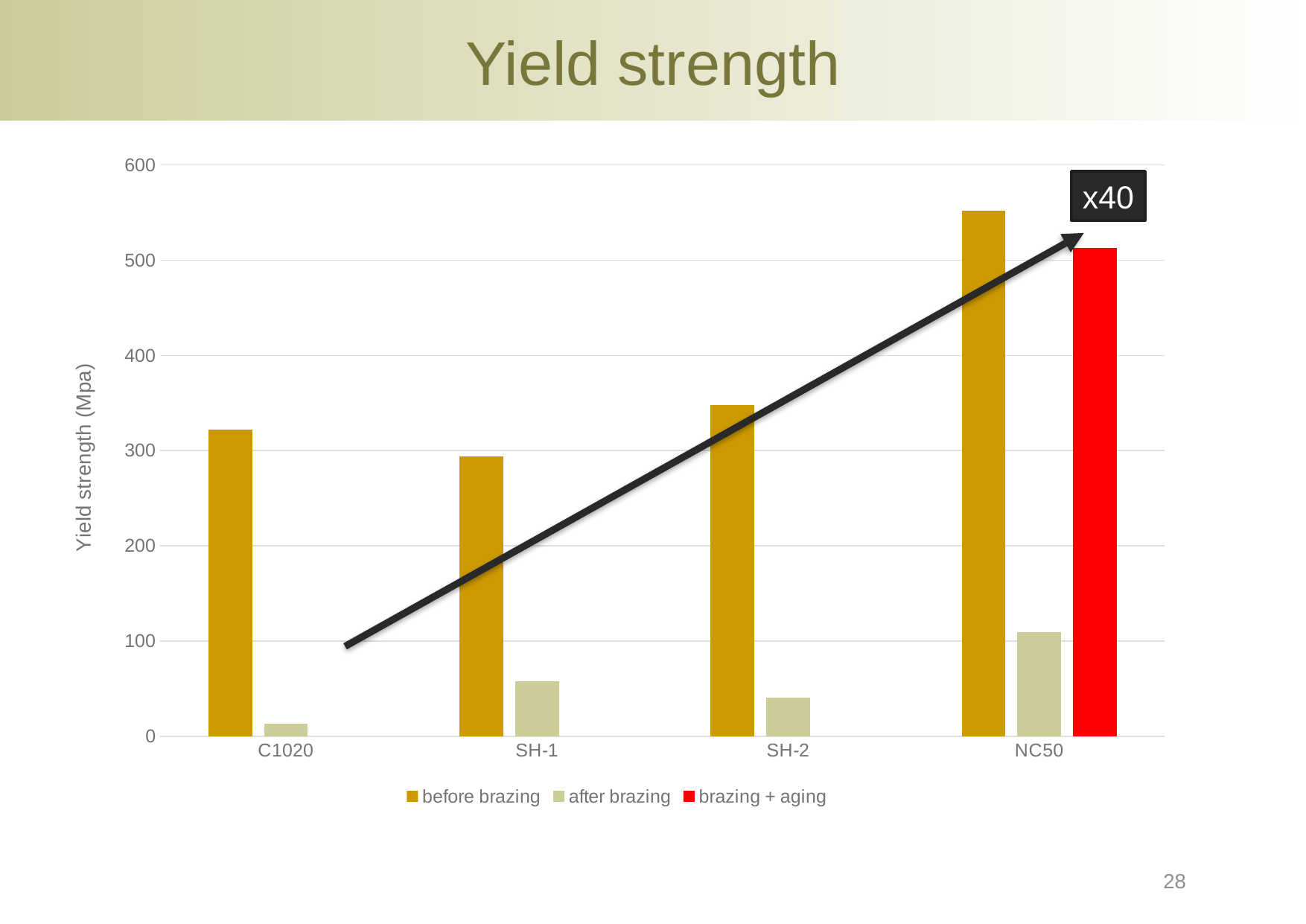
Is the 'before brazing' value for NC50 greater or less than 500? greater What kind of chart is shown on the slide? bar chart Is the 'after brazing' value for SH-1 greater or less than 100? less Which category has the highest 'before brazing' value? NC50 Which category is the only one with a 'brazing + aging' bar? NC50 How many categories are shown on the x axis? 4 Which is larger for SH-2: the 'before brazing' value or the 'after brazing' value? before brazing How many series does the legend list? 3 Which category has the lowest 'before brazing' value? SH-1 Which category has the lowest 'after brazing' value? C1020 Which category has the highest 'after brazing' value? NC50 Is the 'brazing + aging' value for NC50 greater or less than 500? greater